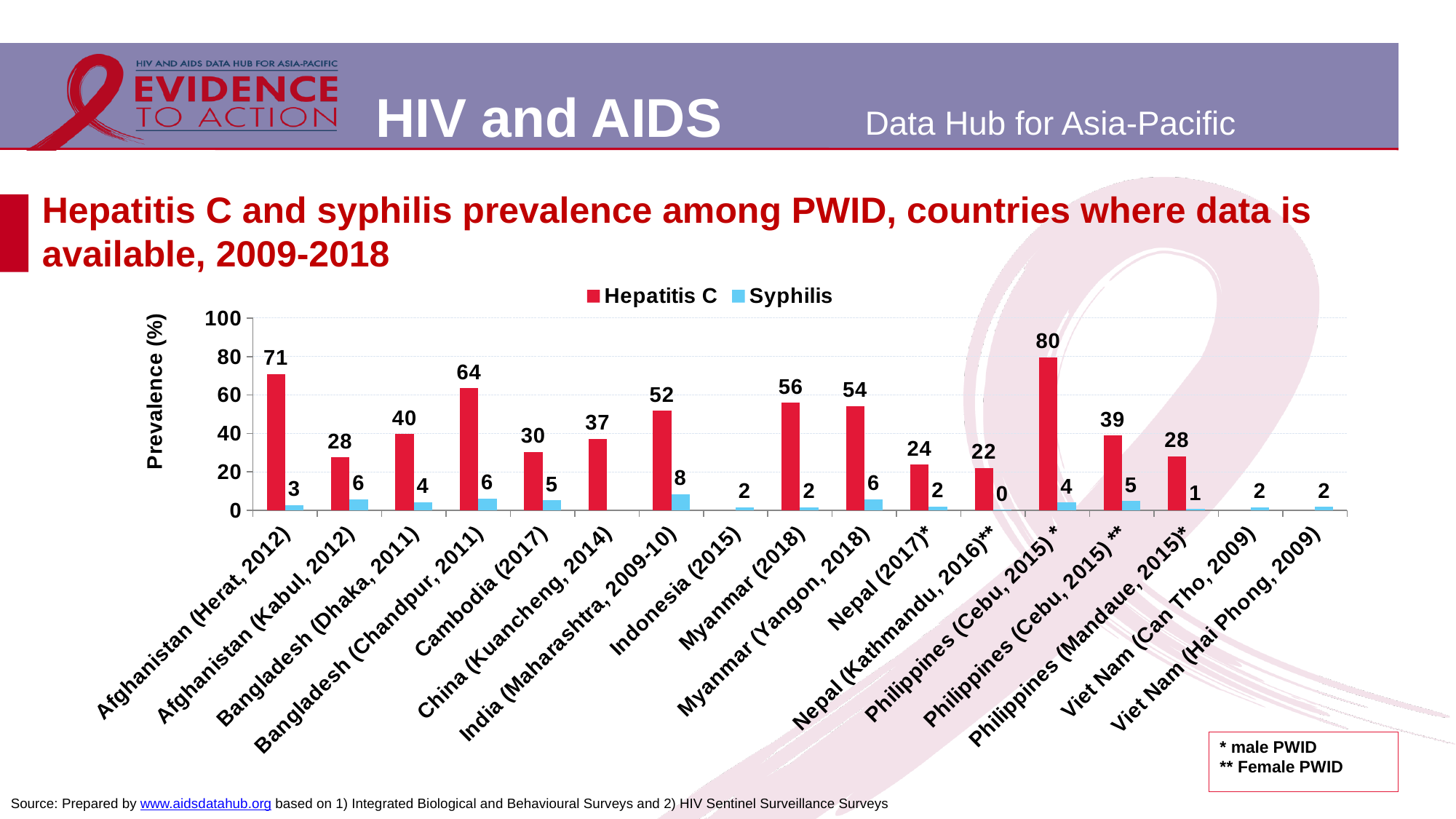
What is the Syphilis prevalence for India (Maharashtra, 2009-10)? 8 What is the Hepatitis C prevalence for Afghanistan (Herat, 2012)? 71 Which is larger, the Hepatitis C prevalence for Myanmar (2018) or for Myanmar (Yangon, 2018)? Myanmar (2018) Which category has the highest Hepatitis C prevalence? Philippines (Cebu, 2015) * How many series does the legend list? 2 What is the difference between the Hepatitis C prevalence for Bangladesh (Chandpur, 2011) and Bangladesh (Dhaka, 2011)? 24 Is the Hepatitis C prevalence for Cambodia (2017) greater or less than 40? less What kind of chart is shown on the slide? bar chart What is the Hepatitis C prevalence for Nepal (Kathmandu, 2016)**? 22 What is the label of the y axis? Prevalence (%) How many categories are shown on the x axis? 17 Which category has the lowest Syphilis prevalence? Nepal (Kathmandu, 2016)**